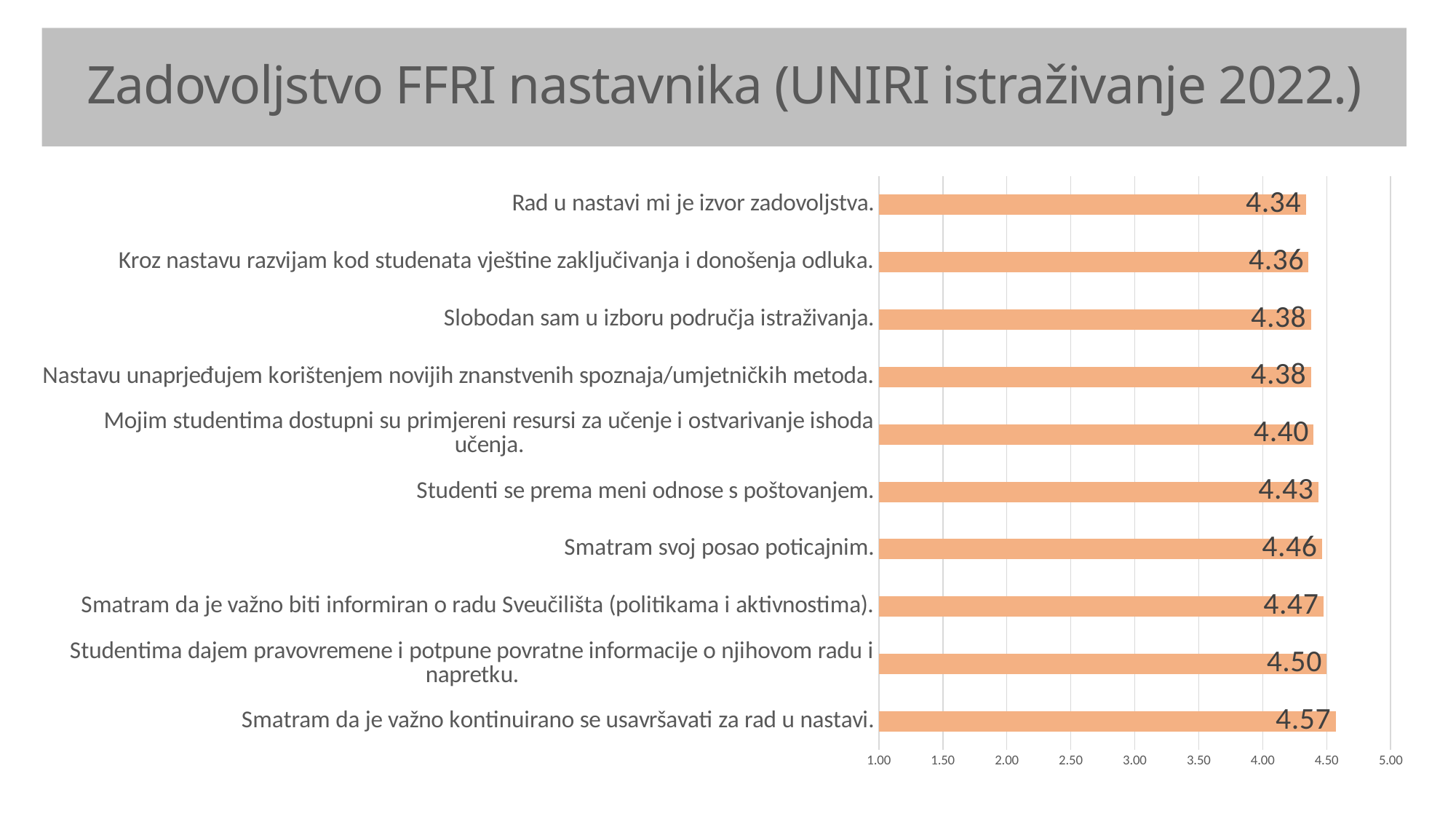
Is the value for "Studentima dajem pravovremene i potpune povratne informacije o njihovom radu i napretku." greater or less than 4.00? greater What is the maximum value shown on the horizontal axis? 5.00 How many categories (statements) are plotted in the chart? 10 What is the difference between the highest value (4.57) and the lowest value (4.34)? 0.23 What is the title of the chart on the slide? Zadovoljstvo FFRI nastavnika (UNIRI istraživanje 2022.) Which statement has the lowest value? Rad u nastavi mi je izvor zadovoljstva. What type of chart is shown on the slide? bar chart Which statement has the highest value? Smatram da je važno kontinuirano se usavršavati za rad u nastavi. What is the value for "Rad u nastavi mi je izvor zadovoljstva."? 4.34 Which is larger: the value for "Smatram svoj posao poticajnim." or the value for "Slobodan sam u izboru područja istraživanja."? Smatram svoj posao poticajnim. What is the value for "Studenti se prema meni odnose s poštovanjem."? 4.43 What is the value for "Smatram svoj posao poticajnim."? 4.46